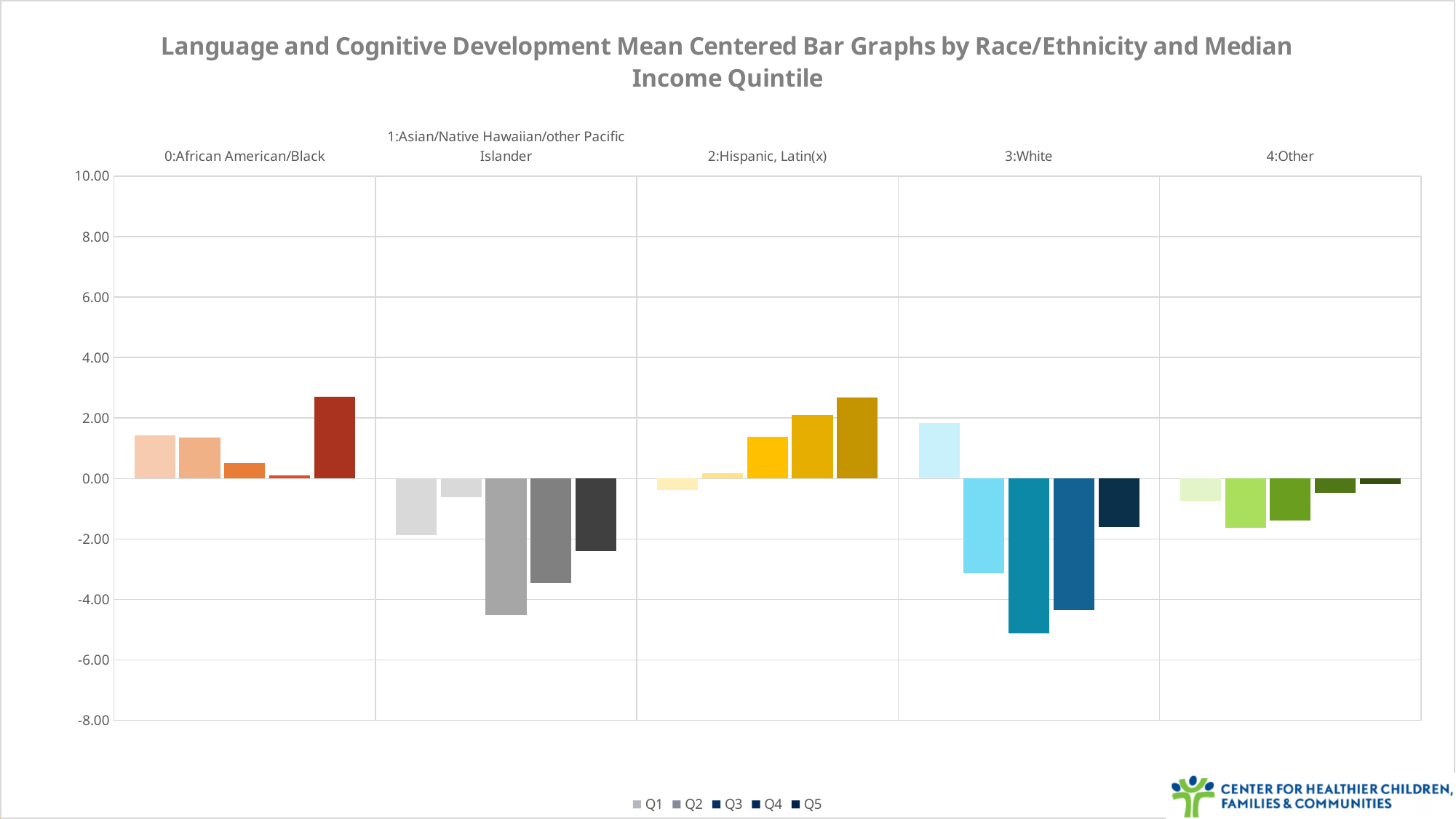
Is the value for Q4 in the 1:Asian/Native Hawaiian/other Pacific Islander group greater or less than -2.00? less What kind of chart is shown on the slide? bar chart Within the 1:Asian/Native Hawaiian/other Pacific Islander group, which quintile has the lowest value? Q3 How many race/ethnicity groups are shown along the x axis? 5 What is the title of the chart? Language and Cognitive Development Mean Centered Bar Graphs by Race/Ethnicity and Median Income Quintile Within the 2:Hispanic, Latin(x) group, which quintile has the highest value? Q5 Which is lower, Q3 for 3:White or Q3 for 1:Asian/Native Hawaiian/other Pacific Islander? Q3 for 3:White Is the value for Q3 in the 3:White group greater or less than -4.00? less Is the value for Q5 in the 0:African American/Black group greater or less than 2.00? greater How many series does the legend list? 5 Which quintile bar is the lowest on the entire chart, and in which group? Q3 in 3:White In the 2:Hispanic, Latin(x) group, do the values rise or fall from Q1 to Q5? rise